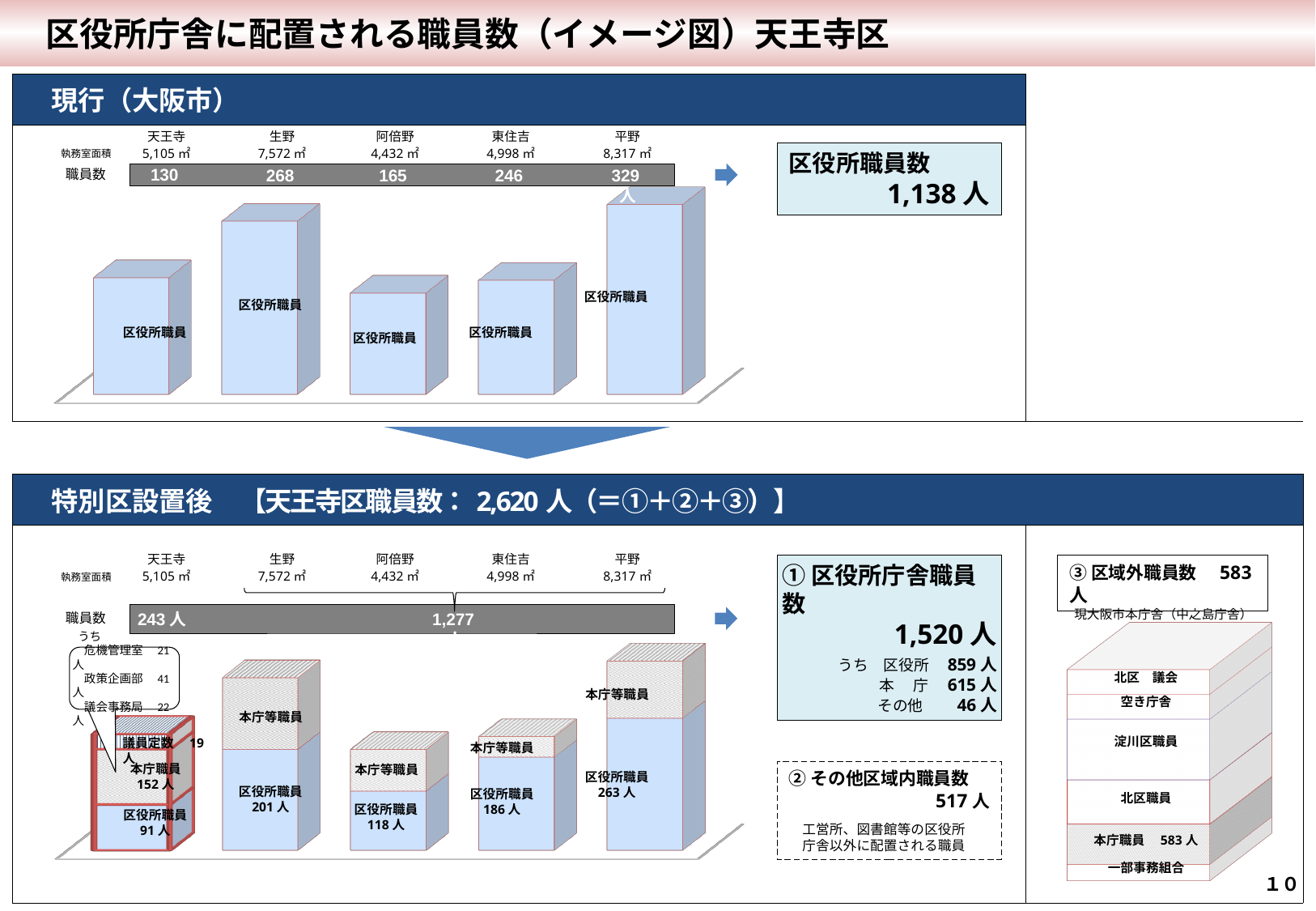
In the bottom chart (特別区設置後), what is the 職員数 shown for 天王寺? 243 人 In the top chart (現行（大阪市）), what is the total 区役所職員数 shown in the box on the right? 1,138 人 In the top chart (現行（大阪市）), which ward has the lowest number of 職員? 天王寺 In the bottom chart (特別区設置後), how many 区役所職員 are shown for 平野? 263 人 In the top chart (現行（大阪市）), which ward has the highest number of 職員? 平野 In the top chart (現行（大阪市）), which has more 職員, 東住吉 or 阿倍野? 東住吉 In the top chart (現行（大阪市）), what is the difference in 職員数 between 生野 and 阿倍野? 103 How many wards are shown in the top chart (現行（大阪市）)? 5 In the top chart (現行（大阪市）), what is the 執務室面積 for 生野? 7,572 ㎡ In the bottom chart (特別区設置後), how many 区役所職員 are shown for 天王寺? 91 人 In the top chart (現行（大阪市）), how many 区役所職員 are shown for 平野? 329 In the top chart (現行（大阪市）), how many 区役所職員 are shown for 天王寺? 130